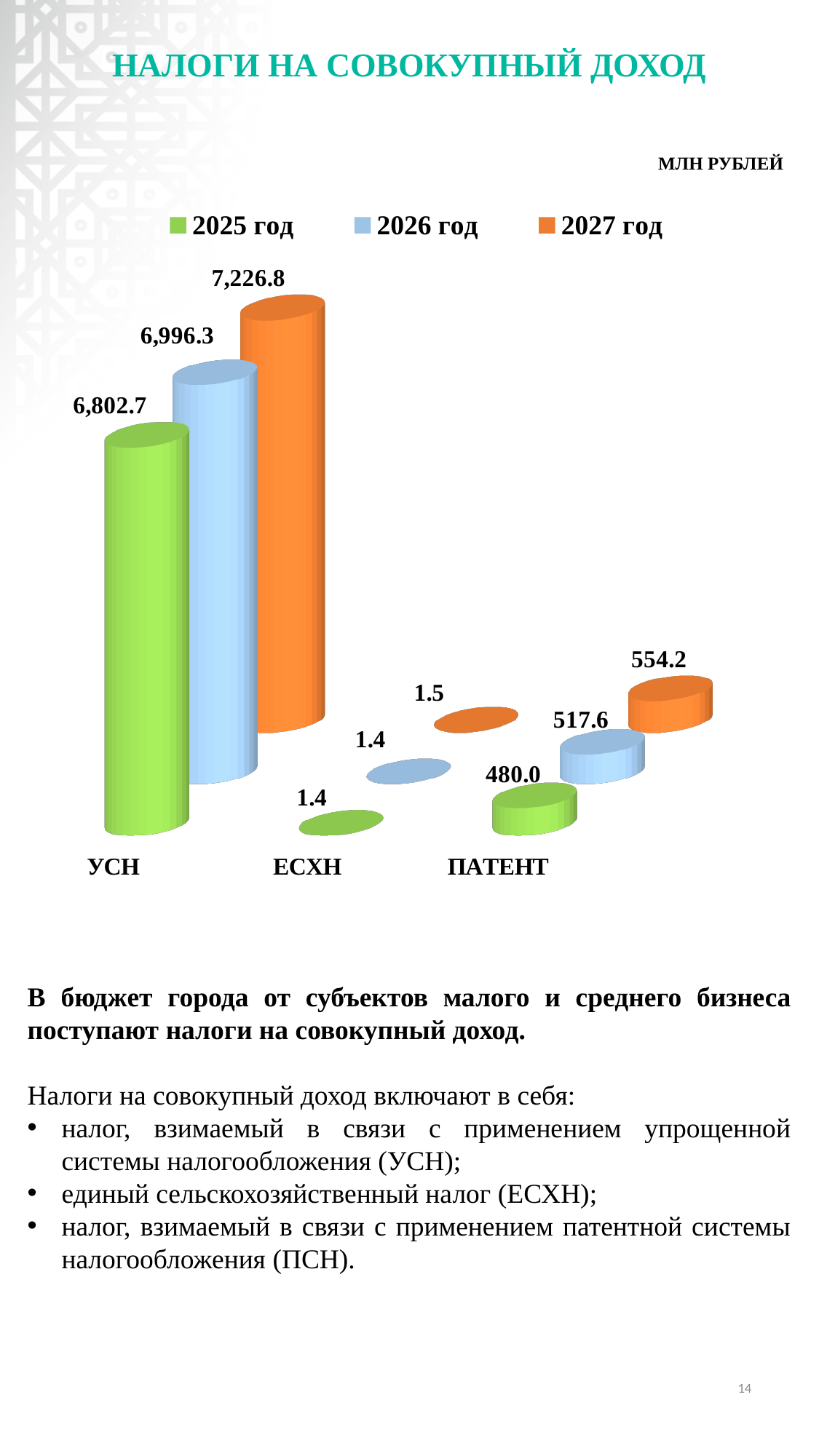
What is the difference between the УСН values for 2027 год and 2025 год? 424.1 How many categories are shown on the x axis of the chart? 3 What is the value for УСН in 2026 год? 6,996.3 Which category has the lowest value in 2025 год? ЕСХН What is the difference between the ПАТЕНТ values for 2027 год and 2025 год? 74.2 What is the value for УСН in 2025 год? 6,802.7 Which category has the highest value in 2027 год? УСН What is the value for ЕСХН in 2026 год? 1.4 Do the values for УСН rise or fall from 2025 год to 2027 год? rise What is the value for ПАТЕНТ in 2027 год? 554.2 How many series does the chart legend list? 3 Which is larger for ПАТЕНТ: the 2026 год value or the 2025 год value? 2026 год